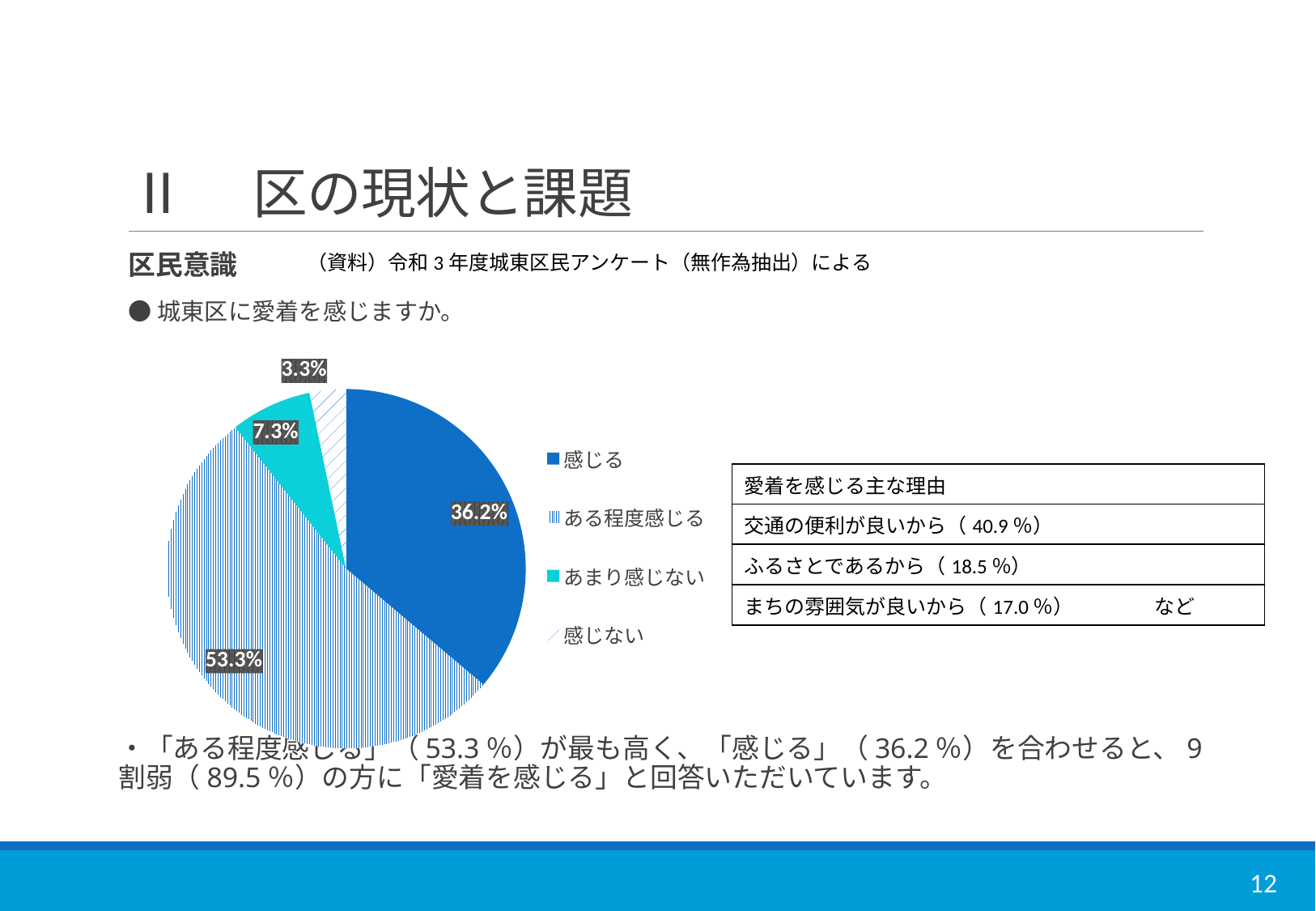
Which response has the smallest share of the pie? 感じない How many entries does the legend list? 4 What percentage of respondents answered 「感じる」? 36.2% What percentage of respondents answered 「ある程度感じる」? 53.3% What percentage of respondents answered 「感じない」? 3.3% What is the combined share of 「感じる」 and 「ある程度感じる」? 89.5% What kind of chart is shown on the slide? pie chart What percentage of respondents answered 「あまり感じない」? 7.3% Which is larger, the share for 「あまり感じない」 or the share for 「感じない」? あまり感じない How many slices does the pie chart have? 4 Which response has the largest share of the pie? ある程度感じる What is the difference in percentage points between 「ある程度感じる」 and 「感じる」? 17.1